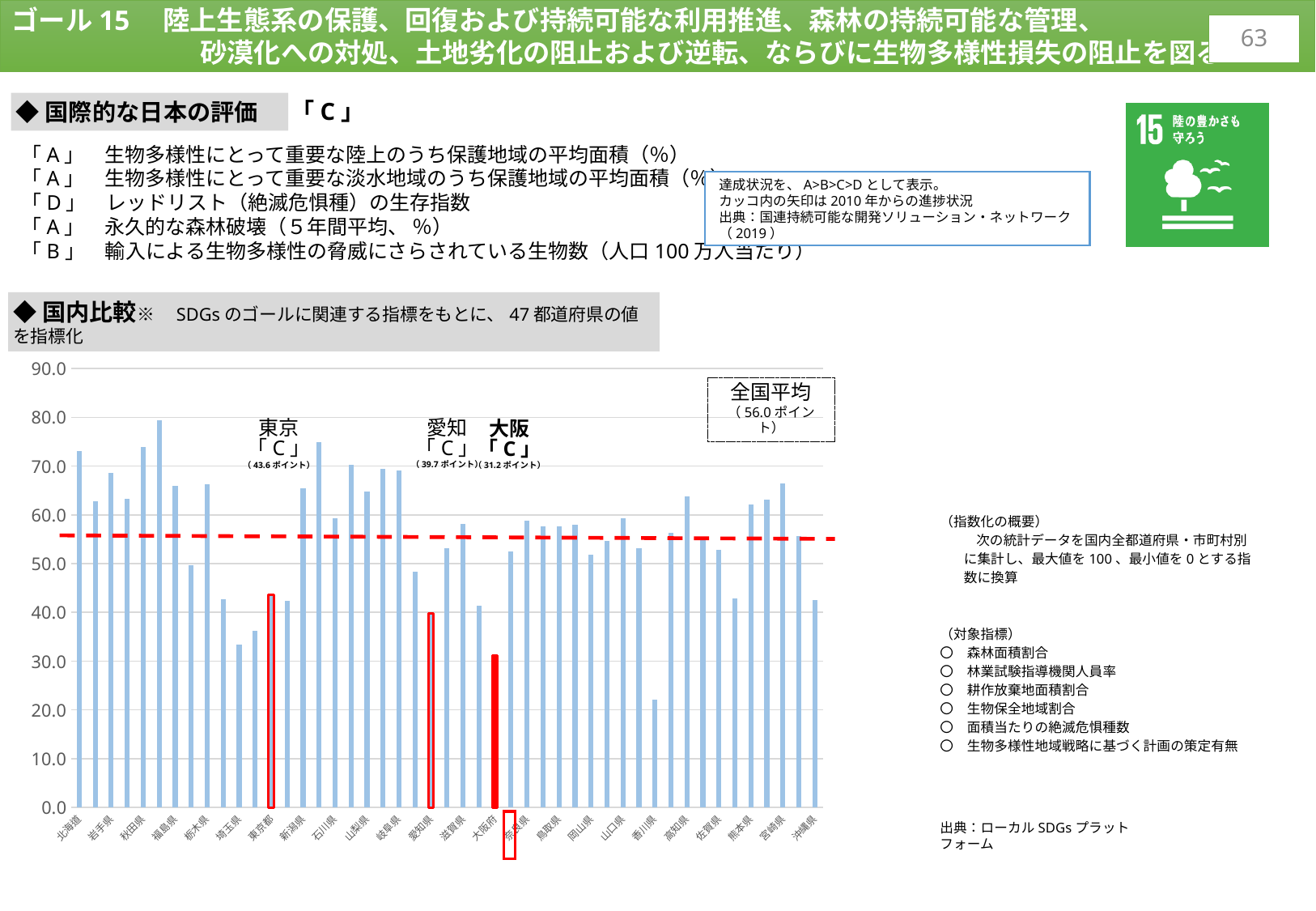
What is the value shown for 東京 in the 国内比較 bar chart? 43.6 ポイント What is the 全国平均 value indicated on the 国内比較 chart? 56.0 ポイント In the 国内比較 chart, is the value for 香川県 greater or less than 30.0? less What does the red dashed horizontal line in the 国内比較 chart represent? 全国平均 In the 国内比較 chart, which is larger, the value for 東京 or the value for 大阪? 東京 In the 国内比較 chart, is the value for 北海道 greater or less than 70.0? greater What is the value shown for 愛知 in the 国内比較 bar chart? 39.7 ポイント In the 国内比較 chart, which labeled prefecture has the lowest bar? 香川県 What is the value shown for 大阪 in the 国内比較 bar chart? 31.2 ポイント In the 国内比較 chart, what is the difference between the values for 東京 and 大阪? 12.4 ポイント What kind of chart is used for the 国内比較 section? bar chart In the 国内比較 chart, what is the difference between the values for 愛知 and 大阪? 8.5 ポイント